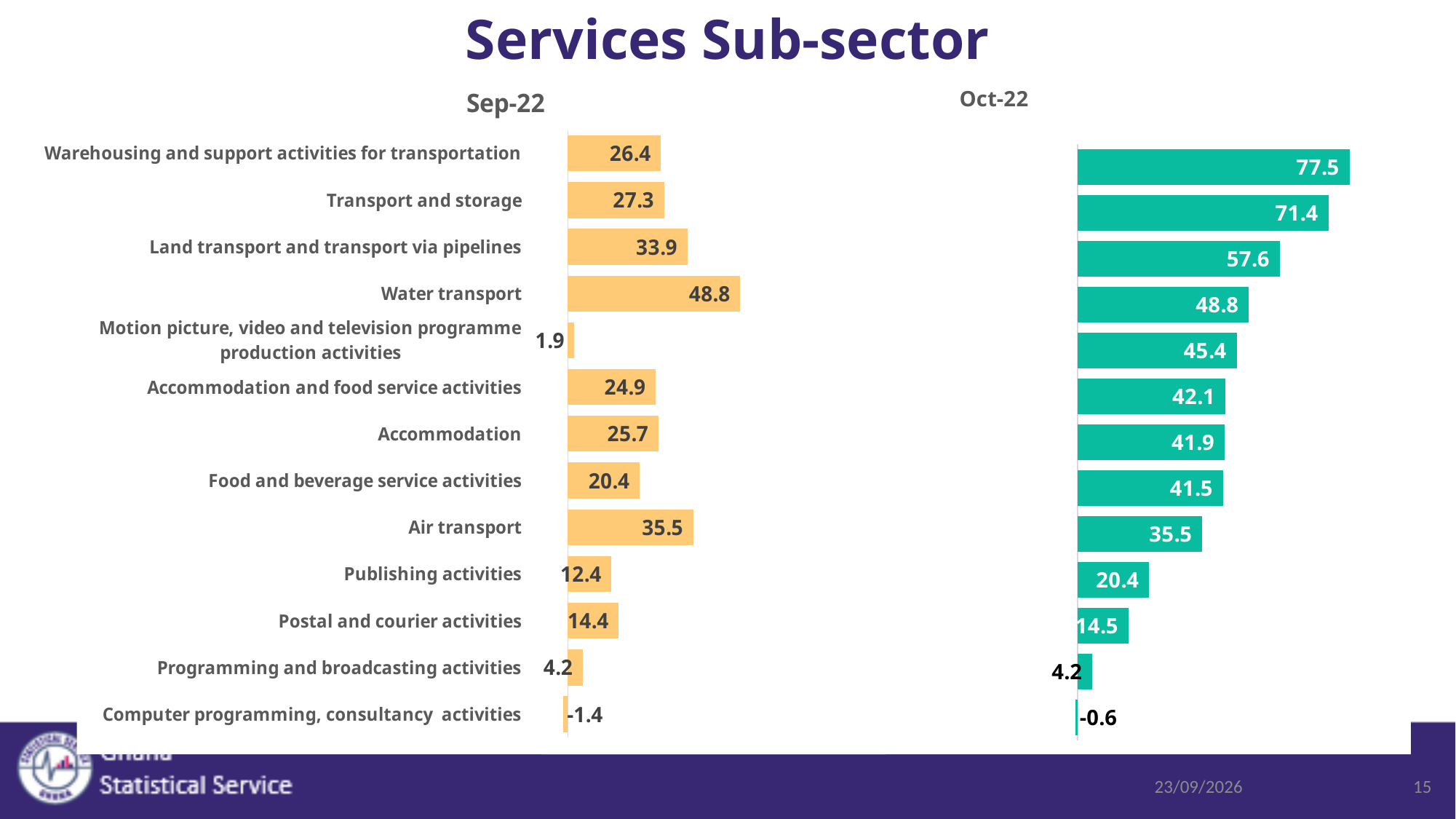
In the Sep-22 chart, what is the difference between Accommodation and Food and beverage service activities? 5.3 In the Oct-22 chart, which category has the lowest value? Computer programming, consultancy activities In the Oct-22 chart, what is the value for Postal and courier activities? 14.5 In the Sep-22 chart, which category has the highest value? Water transport In the Sep-22 chart, what is the value for Motion picture, video and television programme production activities? 1.9 What kind of chart is the Oct-22 chart? Bar chart In the Sep-22 chart, what is the value for Water transport? 48.8 How many categories are shown in the Sep-22 chart? 13 In the Sep-22 chart, which is larger: Air transport or Land transport and transport via pipelines? Air transport What colour are the bars in the Oct-22 chart? Teal In the Oct-22 chart, what is the value for Warehousing and support activities for transportation? 77.5 In the Oct-22 chart, what is the difference between Warehousing and support activities for transportation and Transport and storage? 6.1